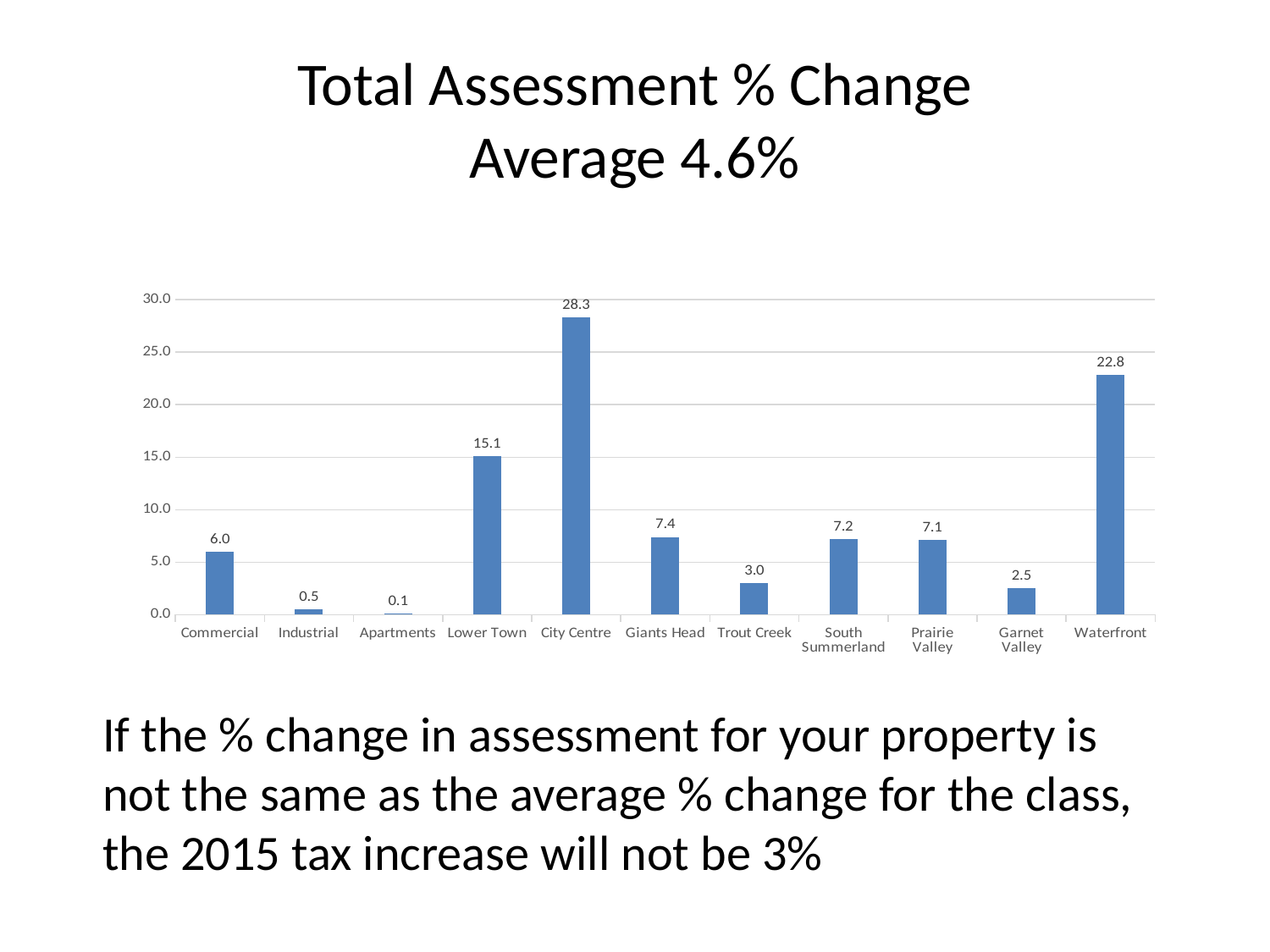
What is the value for Apartments? 0.1 What is the value for Waterfront? 22.8 Which is larger, the value for Commercial or the value for Trout Creek? Commercial What average is stated in the chart title? 4.6% How many categories are shown on the x axis? 11 What kind of chart is shown on the slide? Bar chart What is the difference between the values for City Centre and Waterfront? 5.5 Is the value for Lower Town greater or less than 10.0? greater What is the value for Lower Town? 15.1 Which category has the highest value? City Centre Which category has the lowest value? Apartments What is the value for City Centre? 28.3